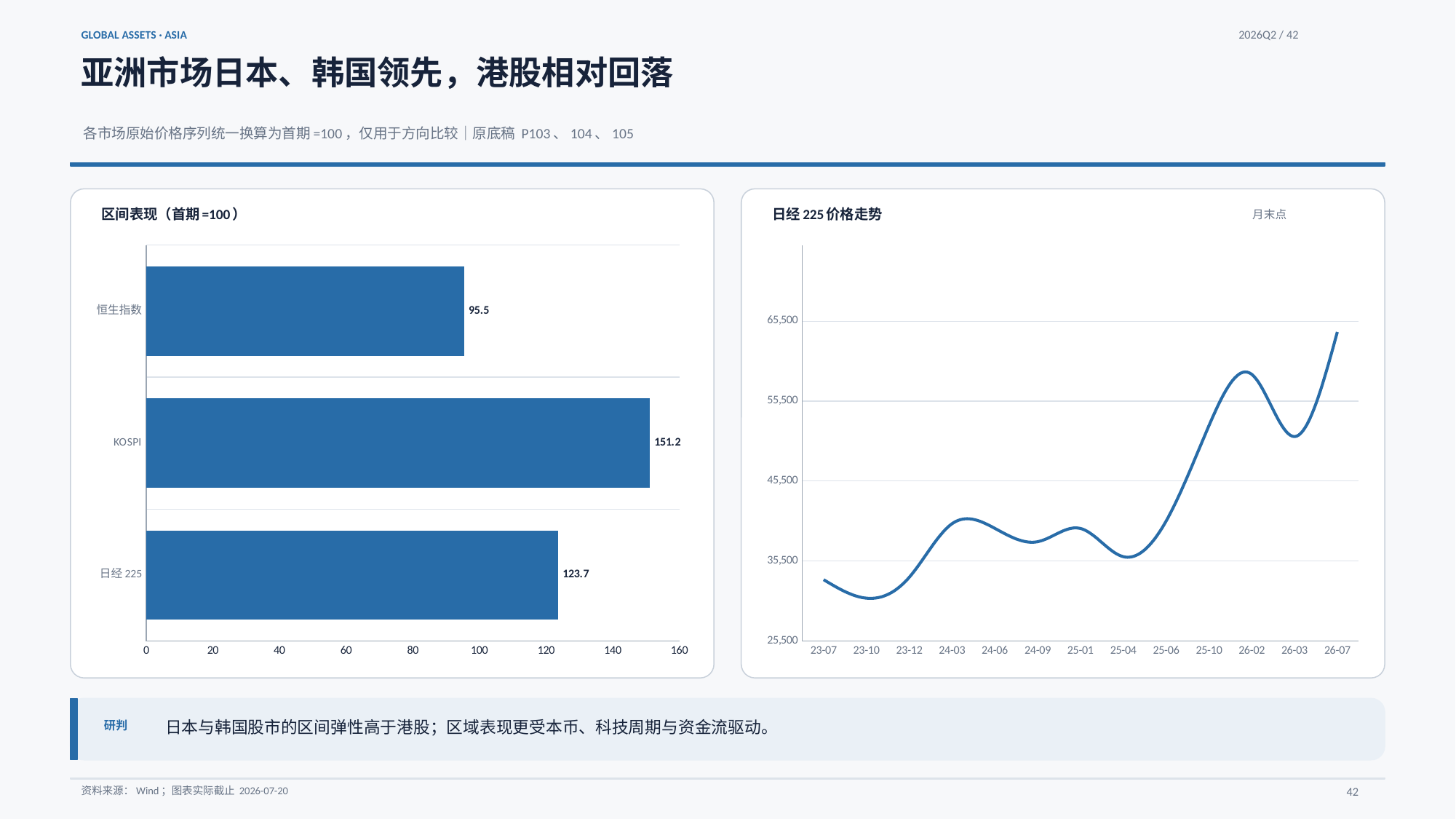
In the chart titled 区间表现（首期=100）, which category has the lowest value? 恒生指数 What kind of chart is the chart titled 日经 225 价格走势? line chart In the chart titled 区间表现（首期=100）, which category has the highest value? KOSPI In the chart titled 区间表现（首期=100）, what is the value for KOSPI? 151.2 In the chart titled 日经 225 价格走势, is the value at 23-07 greater or less than 35,500? less In the chart titled 区间表现（首期=100）, what is the value for 恒生指数? 95.5 What kind of chart is the chart titled 区间表现（首期=100）? bar chart In the chart titled 区间表现（首期=100）, what is the value for 日经 225? 123.7 In the chart titled 区间表现（首期=100）, which is larger, the value for 日经 225 or the value for 恒生指数? 日经 225 In the chart titled 日经 225 价格走势, is the value at 26-07 greater or less than 55,500? greater In the chart titled 区间表现（首期=100）, how many categories are shown? 3 In the chart titled 区间表现（首期=100）, what is the difference between the KOSPI value and the 日经 225 value? 27.5